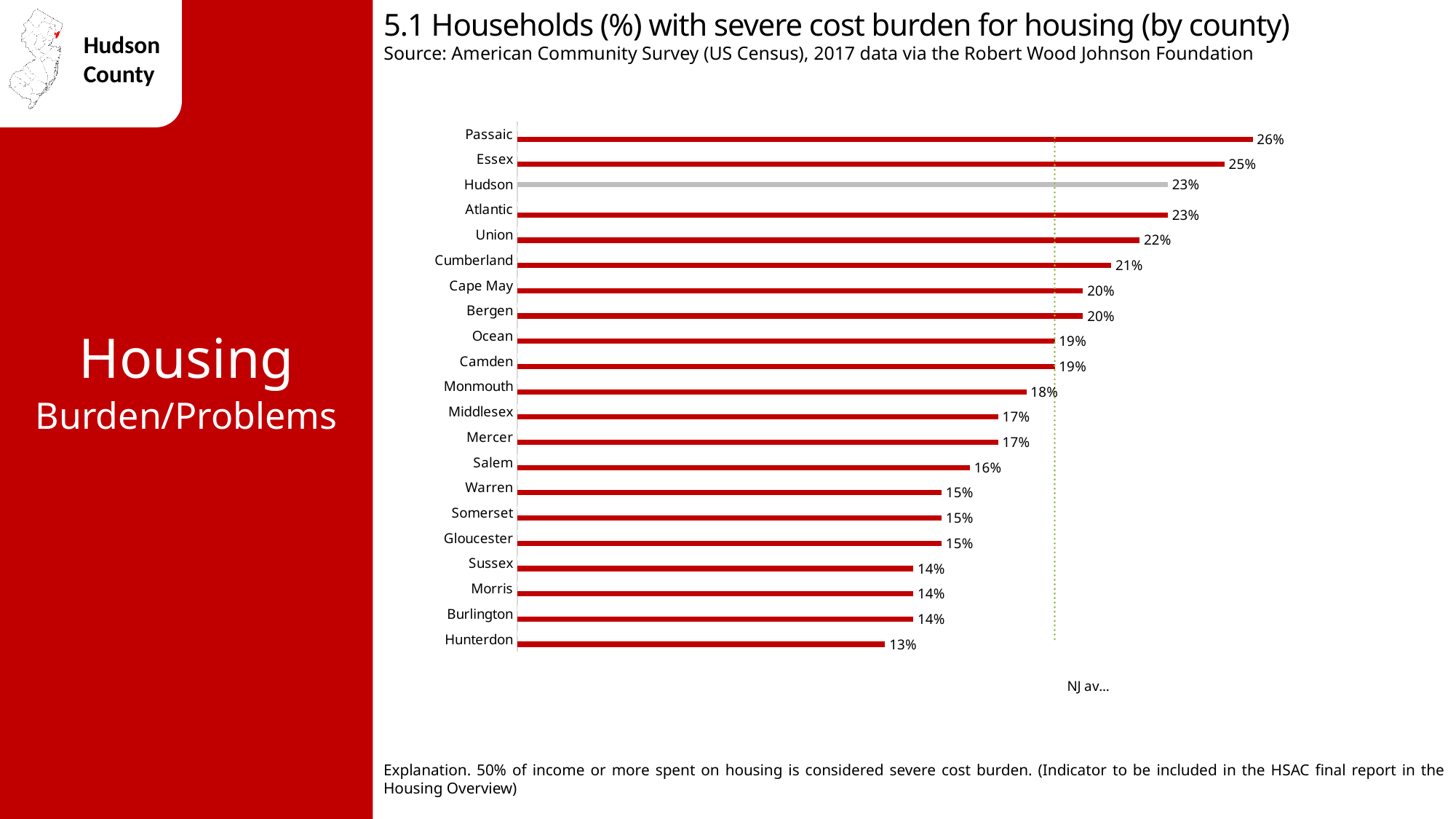
What is the difference between the values for Passaic and Hudson? 3% What is the value for Hudson County? 23% How many counties are shown in the chart? 21 What type of chart is shown on the slide? Bar chart Which county has the highest percentage of households with severe cost burden? Passaic What is the value for Cumberland? 21% Which county has the lowest percentage of households with severe cost burden? Hunterdon What is the value for Hunterdon? 13% What is the difference between the values for Essex and Hunterdon? 12% Which has a larger value, Union or Salem? Union Which county's bar is coloured grey instead of red? Hudson What is the value for Passaic? 26%